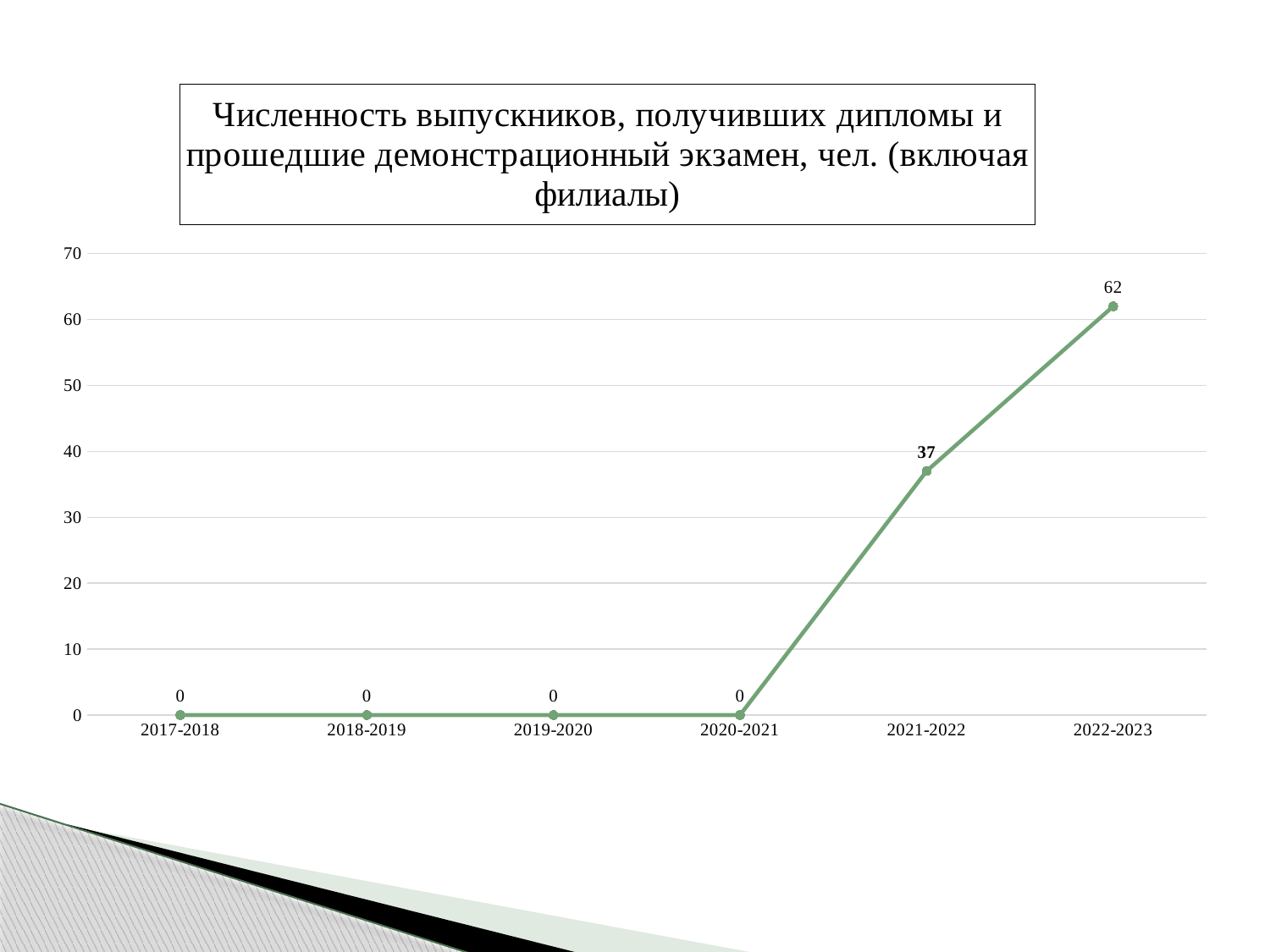
What is the difference between the values for 2022-2023 and 2021-2022? 25 Which academic year has the highest value? 2022-2023 Which is larger, the value for 2021-2022 or the value for 2020-2021? 2021-2022 Is the value for 2022-2023 greater or less than 50? greater What is the value for 2019-2020? 0 What is the value for 2021-2022? 37 How many academic years have a value of 0? 4 How many academic years are plotted on the x axis? 6 What is the value for 2022-2023? 62 Do the values rise or fall from 2020-2021 to 2022-2023? rise What kind of chart is shown on the slide? line chart Is the value for 2021-2022 greater or less than 40? less